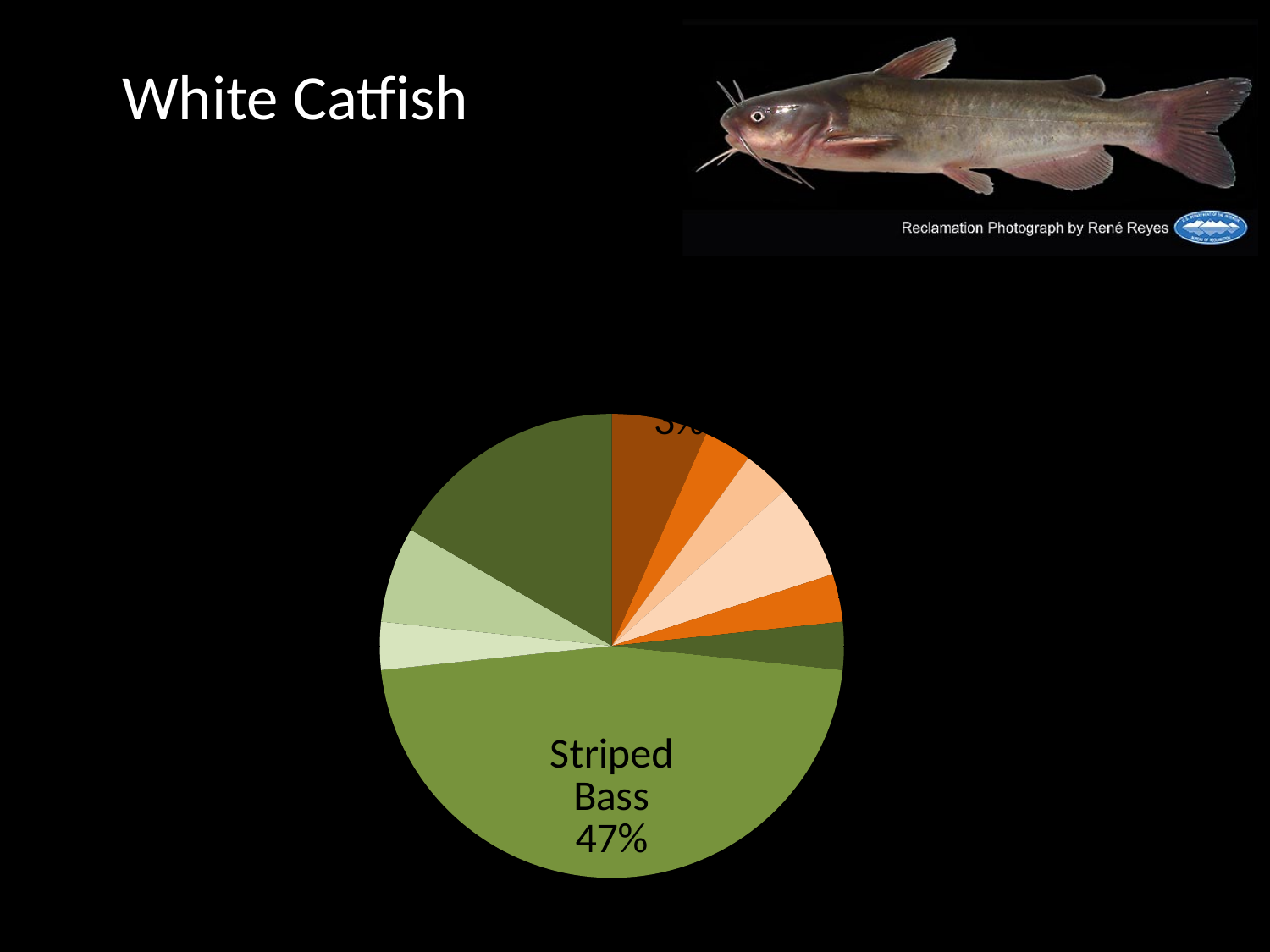
What share of the pie does Striped Bass account for? 47% Which category has the largest slice of the pie? Striped Bass Is the Striped Bass share greater or less than 50%? less What is the value printed on the Striped Bass slice? 47% How many slices does the pie chart have? 10 What colour is the Striped Bass slice? olive green Is the Striped Bass share greater or less than 40%? greater What kind of chart is shown on the slide? pie chart What is the title of the slide containing the pie chart? White Catfish